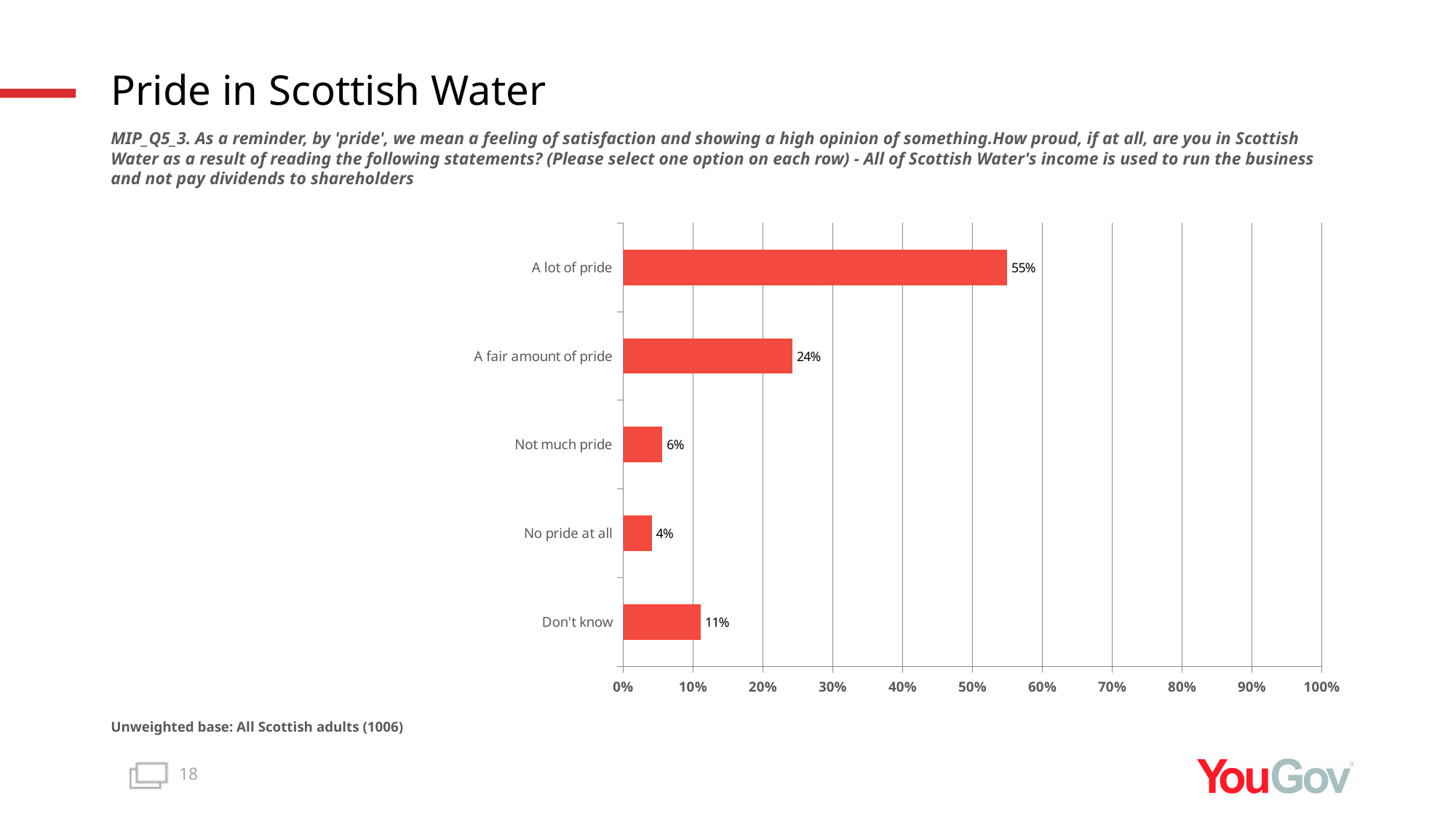
What is the value shown for 'A fair amount of pride'? 24% Is the value for 'A lot of pride' greater or less than 50%? greater Which category has the highest value? A lot of pride What is the title of the slide? Pride in Scottish Water What is the value for 'No pride at all'? 4% What is the difference between 'A lot of pride' and 'A fair amount of pride'? 31% What kind of chart is shown on the slide? Bar chart Which category has the lowest value? No pride at all How many categories are shown on the chart? 5 What percentage of respondents said they feel 'A lot of pride'? 55% Which is larger: 'Not much pride' or 'Don't know'? Don't know What percentage of respondents answered 'Don't know'? 11%